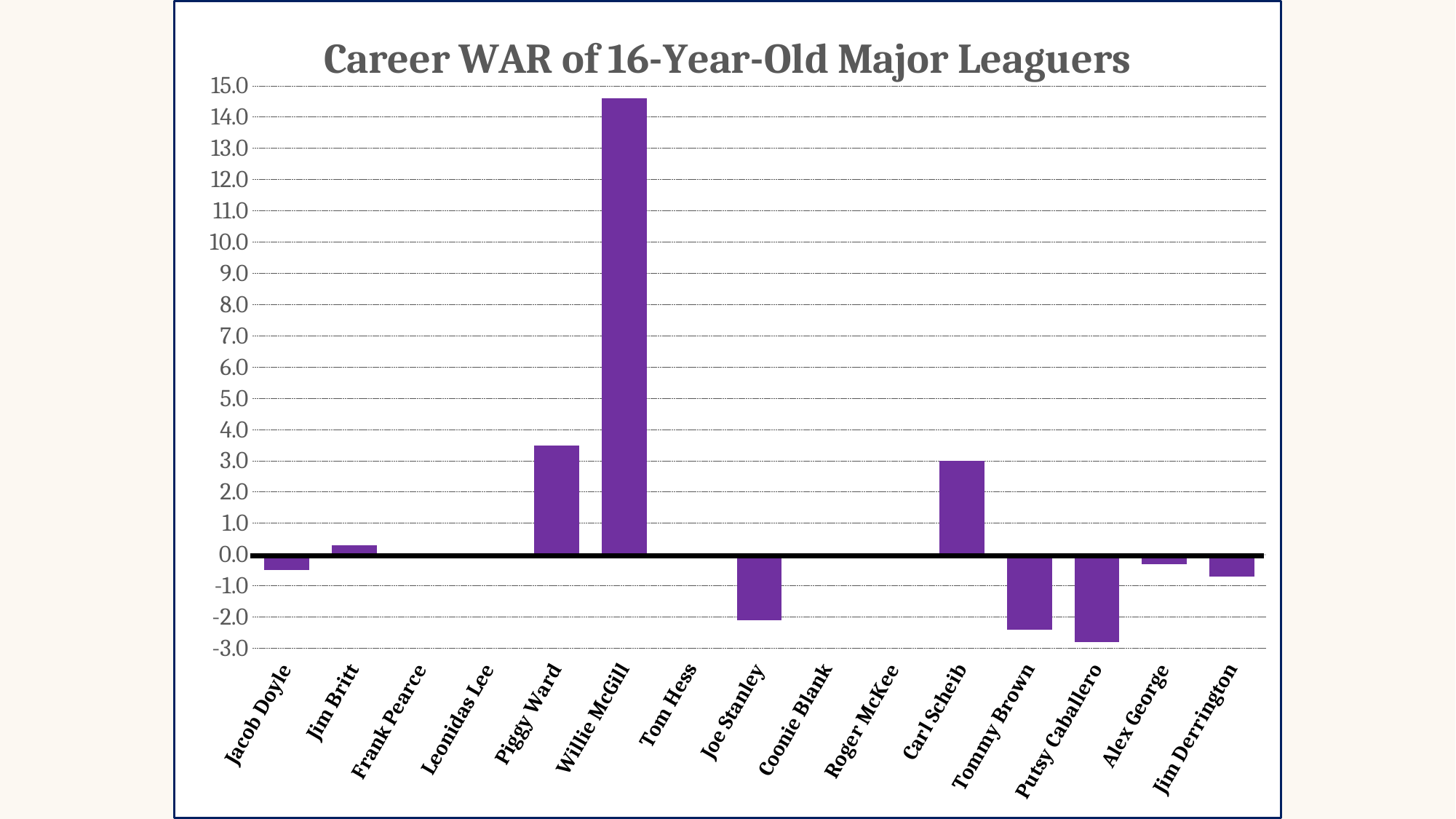
What kind of chart is shown on the slide? bar chart How many players are shown on the x axis of the chart? 15 Which player has the lowest career WAR in the chart? Putsy Caballero Is the value for Piggy Ward greater or less than 3.0? greater Is the value for Willie McGill greater or less than 14.0? greater Which player has the highest career WAR in the chart? Willie McGill Which is larger, the career WAR of Piggy Ward or Carl Scheib? Piggy Ward Which is larger, the career WAR of Jacob Doyle or Jim Britt? Jim Britt Is the value for Tommy Brown greater or less than -2.0? less What is the title of the chart? Career WAR of 16-Year-Old Major Leaguers